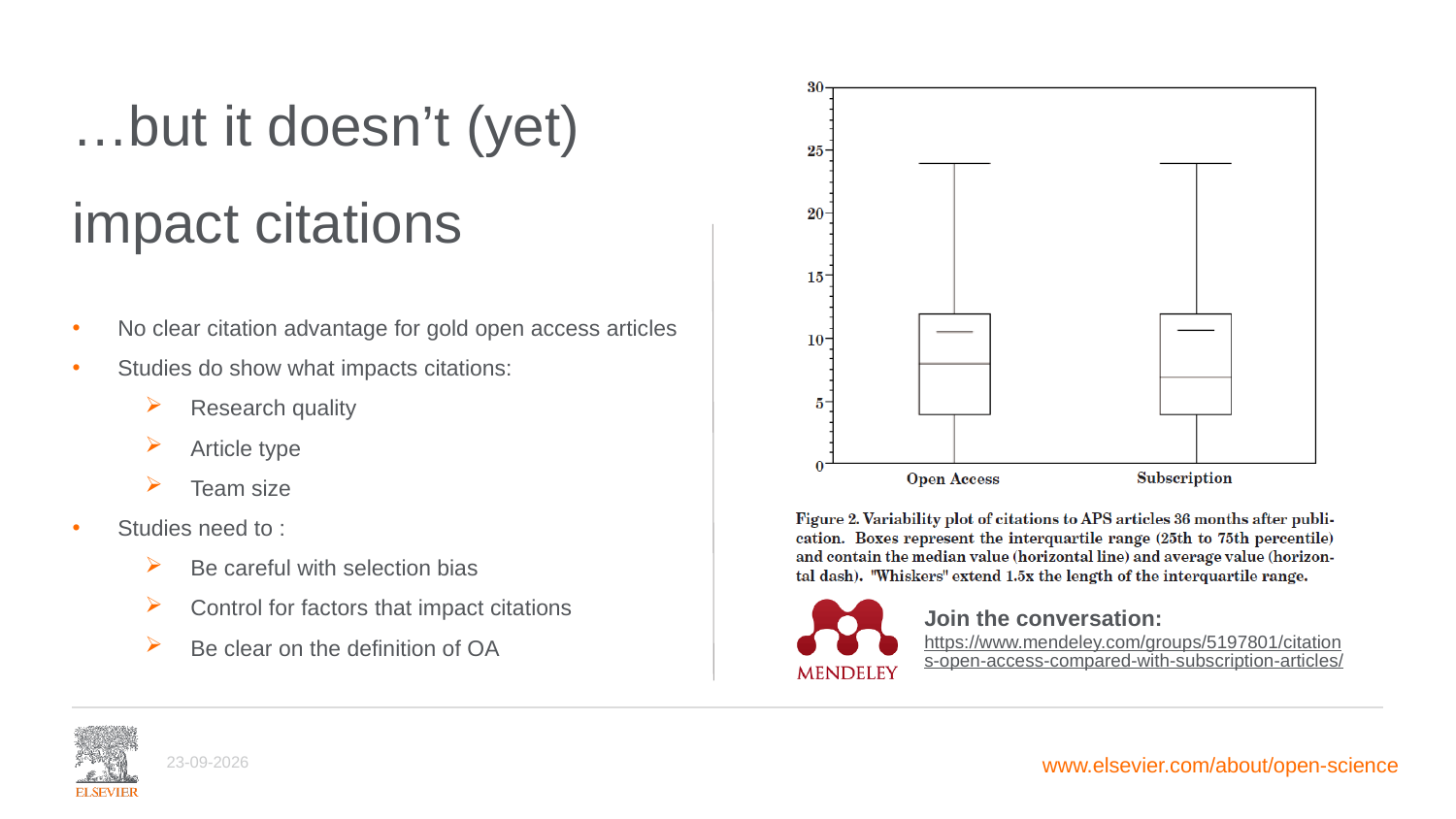
What kind of chart is shown on the right side of the slide? box plot Is the top of the upper whisker for Subscription greater or less than 20? greater Is the median value (horizontal line) for Open Access greater or less than 10? less What is the maximum value shown on the y axis of the box plot? 30 Is the average value (horizontal dash) for Open Access greater or less than 15? less What are the two categories on the x axis of the box plot? Open Access and Subscription How many categories are shown on the x axis of the box plot? 2